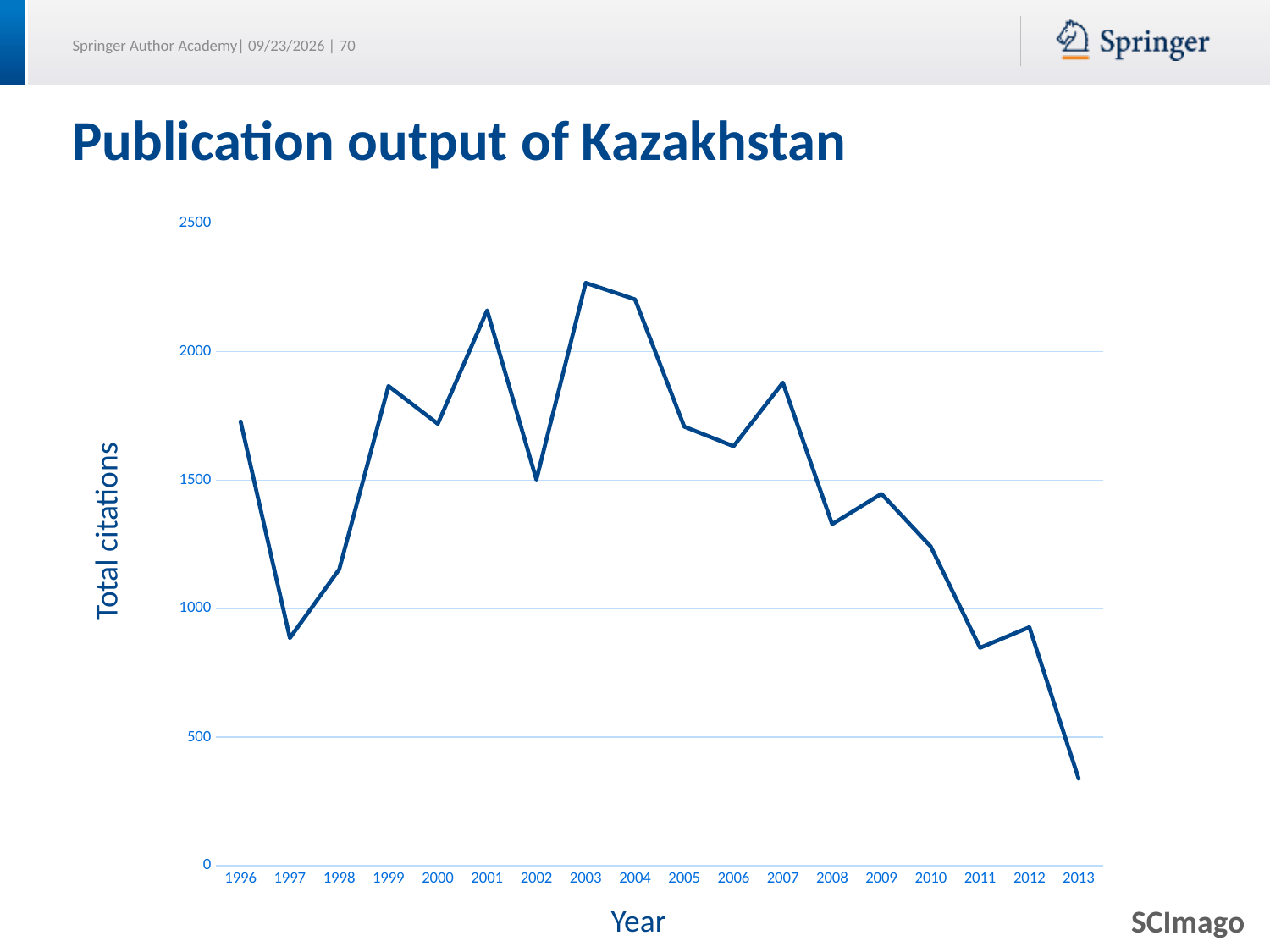
In which year is the total citations value highest? 2003 What is the title of the chart? Publication output of Kazakhstan Is the value for 2008 greater or less than 1500? less Is the value for 2003 greater or less than 2000? greater In which year is the total citations value lowest? 2013 What kind of chart is shown on the slide? line chart Is the value for 2013 greater or less than 500? less Which year has the larger value, 1999 or 1997? 1999 What is the label on the vertical axis? Total citations How many years are plotted along the x axis? 18 Do the values generally rise or fall from 2007 to 2013? fall